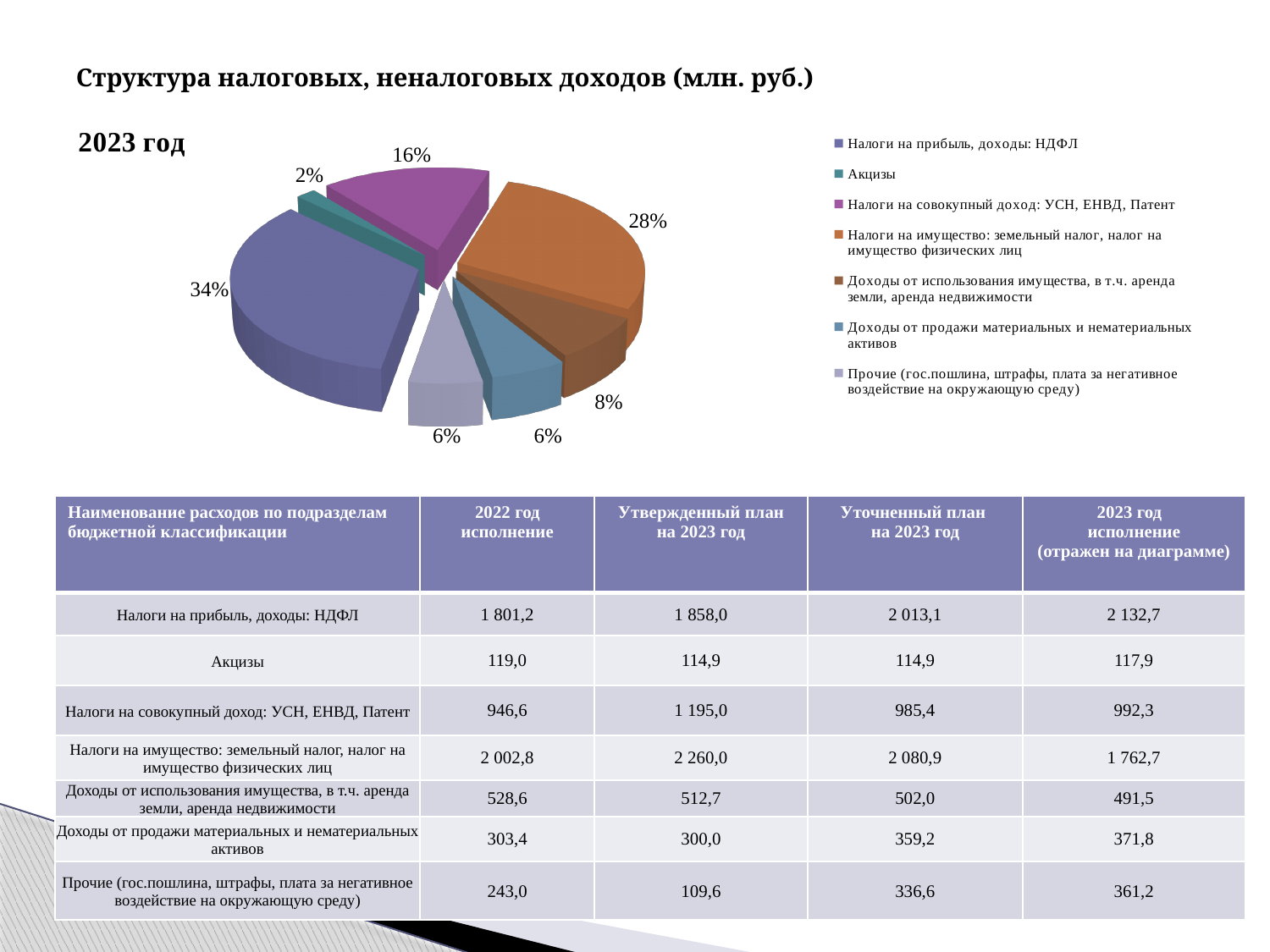
What share of the pie does "Налоги на имущество: земельный налог, налог на имущество физических лиц" have? 28% What share of the pie does "Доходы от использования имущества, в т.ч. аренда земли, аренда недвижимости" have? 8% Which category has the largest slice of the pie? Налоги на прибыль, доходы: НДФЛ How many slices does the pie chart have? 7 What is the difference in percentage points between the НДФЛ slice and the "Налоги на имущество" slice? 6 How many entries does the legend list? 7 What share of the pie does "Налоги на прибыль, доходы: НДФЛ" have? 34% What kind of chart is shown on the slide? pie chart Which slice is larger: "Налоги на совокупный доход: УСН, ЕНВД, Патент" or "Доходы от использования имущества, в т.ч. аренда земли, аренда недвижимости"? Налоги на совокупный доход: УСН, ЕНВД, Патент Which category has the smallest slice of the pie? Акцизы